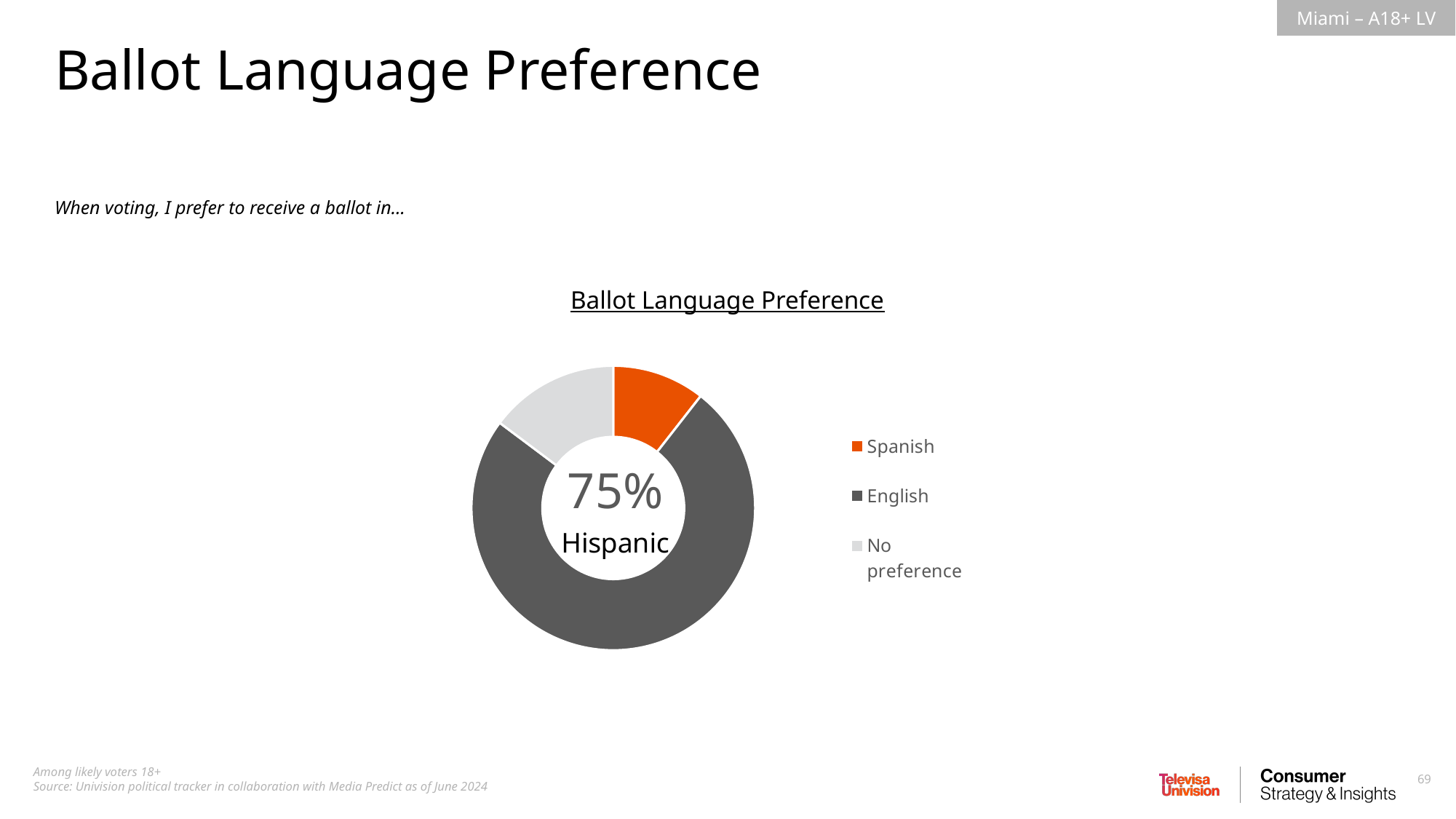
Which category has the largest slice in the Ballot Language Preference chart? English How many entries does the legend of the Ballot Language Preference chart list? 3 What is the title of the chart on the slide? Ballot Language Preference Which slice is larger in the Ballot Language Preference chart, English or No preference? English Which category is shown in orange in the Ballot Language Preference chart? Spanish How many categories does the Ballot Language Preference chart show? 3 What kind of chart is shown on the slide? Pie (donut) chart Which slice is larger in the Ballot Language Preference chart, English or Spanish? English What percentage is printed in the centre of the donut chart? 75%